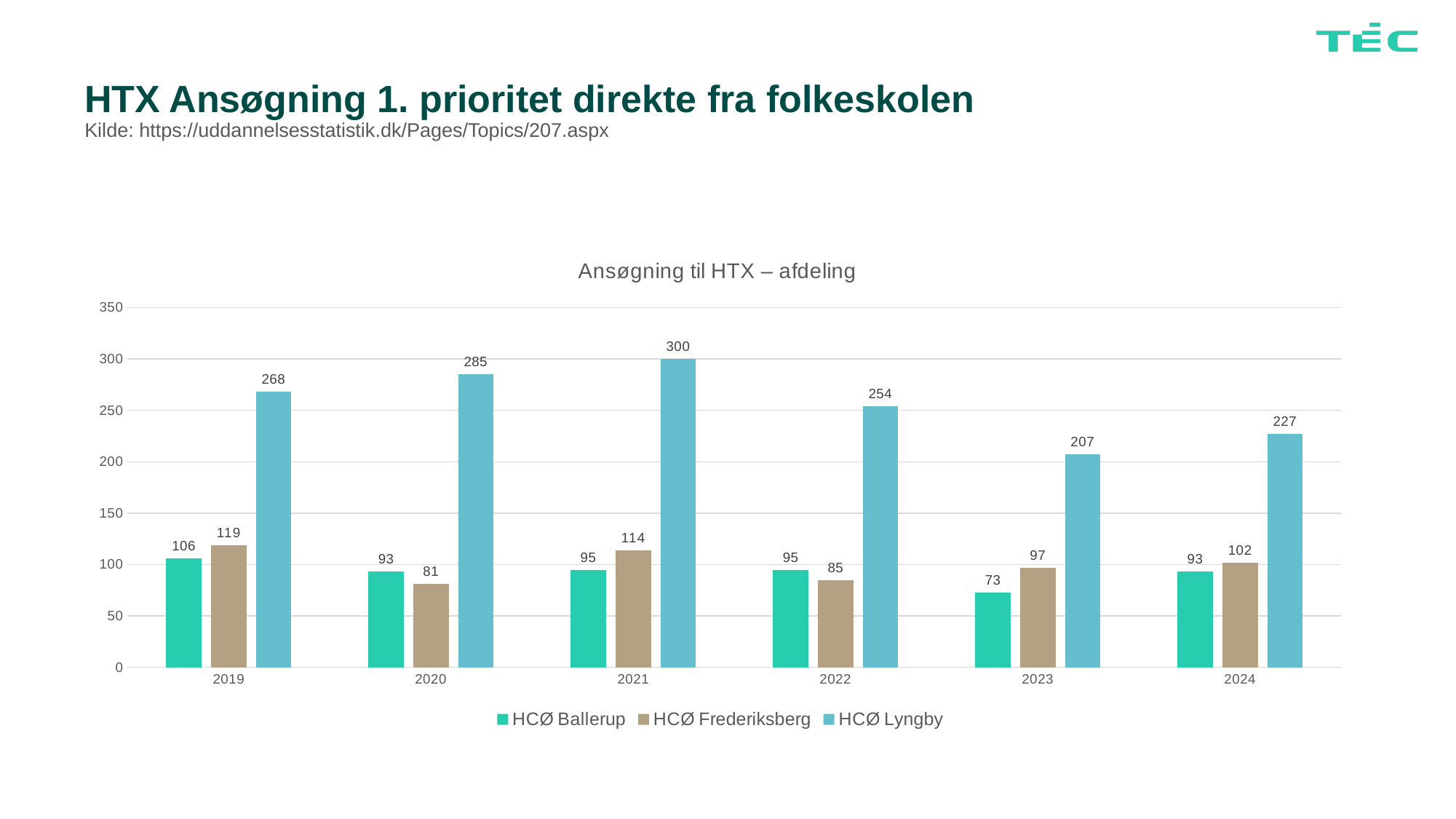
What is the difference between HCØ Lyngby and HCØ Ballerup in 2024? 134 How many years are shown on the x axis? 6 In which year is the HCØ Frederiksberg value lowest? 2020 What is the value for HCØ Ballerup in 2023? 73 What kind of chart is shown? Bar chart What is the value for HCØ Lyngby in 2021? 300 How many series does the legend list? 3 Which is larger in 2022: HCØ Ballerup or HCØ Frederiksberg? HCØ Ballerup What is the value for HCØ Frederiksberg in 2019? 119 In which year is the HCØ Lyngby value highest? 2021 Is the value for HCØ Lyngby in 2023 greater or less than 250? less What is the title of the chart? Ansøgning til HTX – afdeling